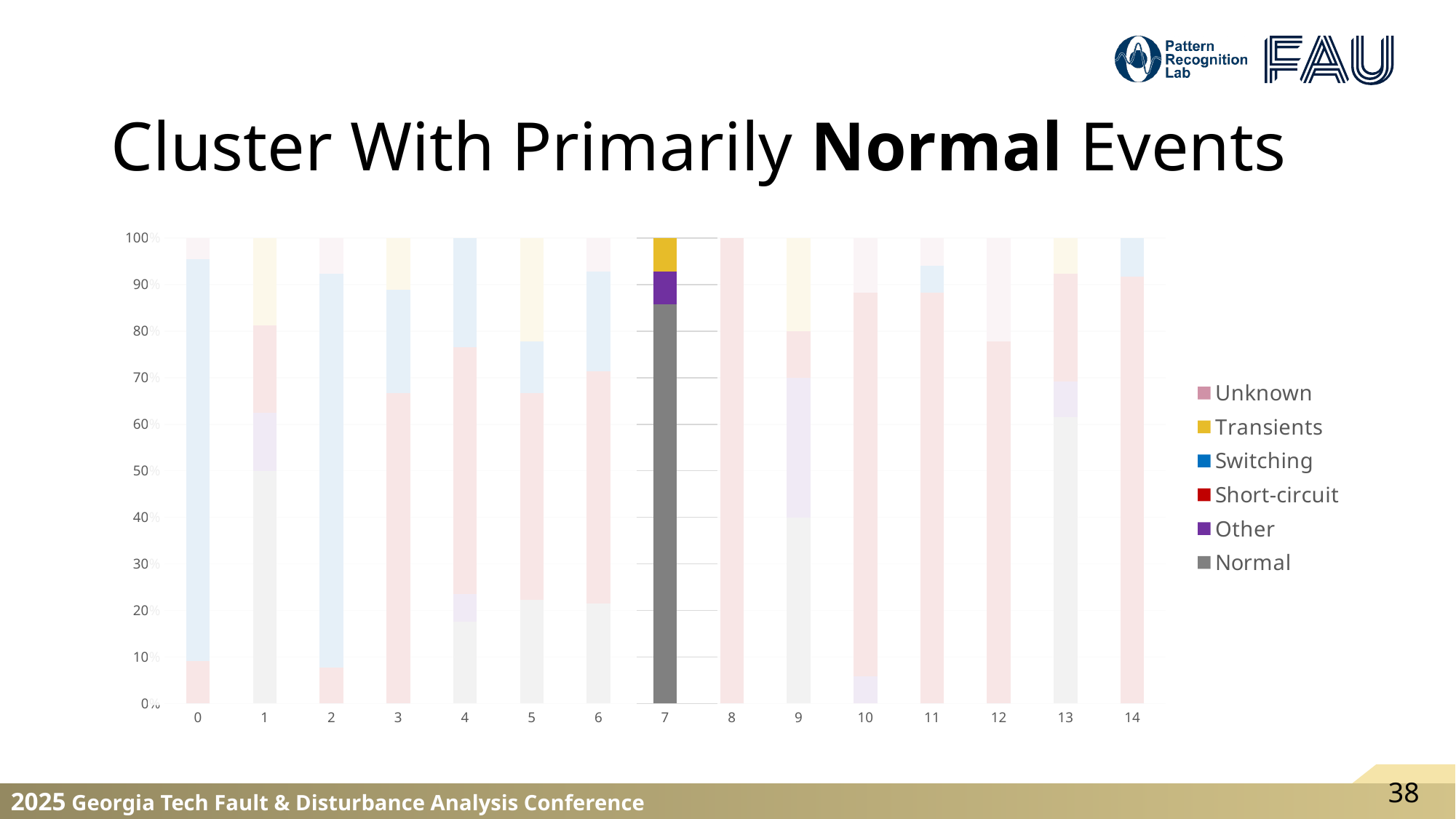
Is the Unknown share for cluster 10 greater or less than 80%? less Which cluster has the largest share of Normal events? 7 Which legend entry is shown in grey? Normal Which cluster is highlighted in full colour on the chart? 7 Is the Switching share for cluster 0 greater or less than 80%? greater Is the Normal share for cluster 7 greater or less than 90%? less How many series does the legend list? 6 What kind of chart is shown on the slide? Stacked bar chart What is the total height of the stacked bar for cluster 7? 100% How many clusters (categories) are shown along the x axis? 15